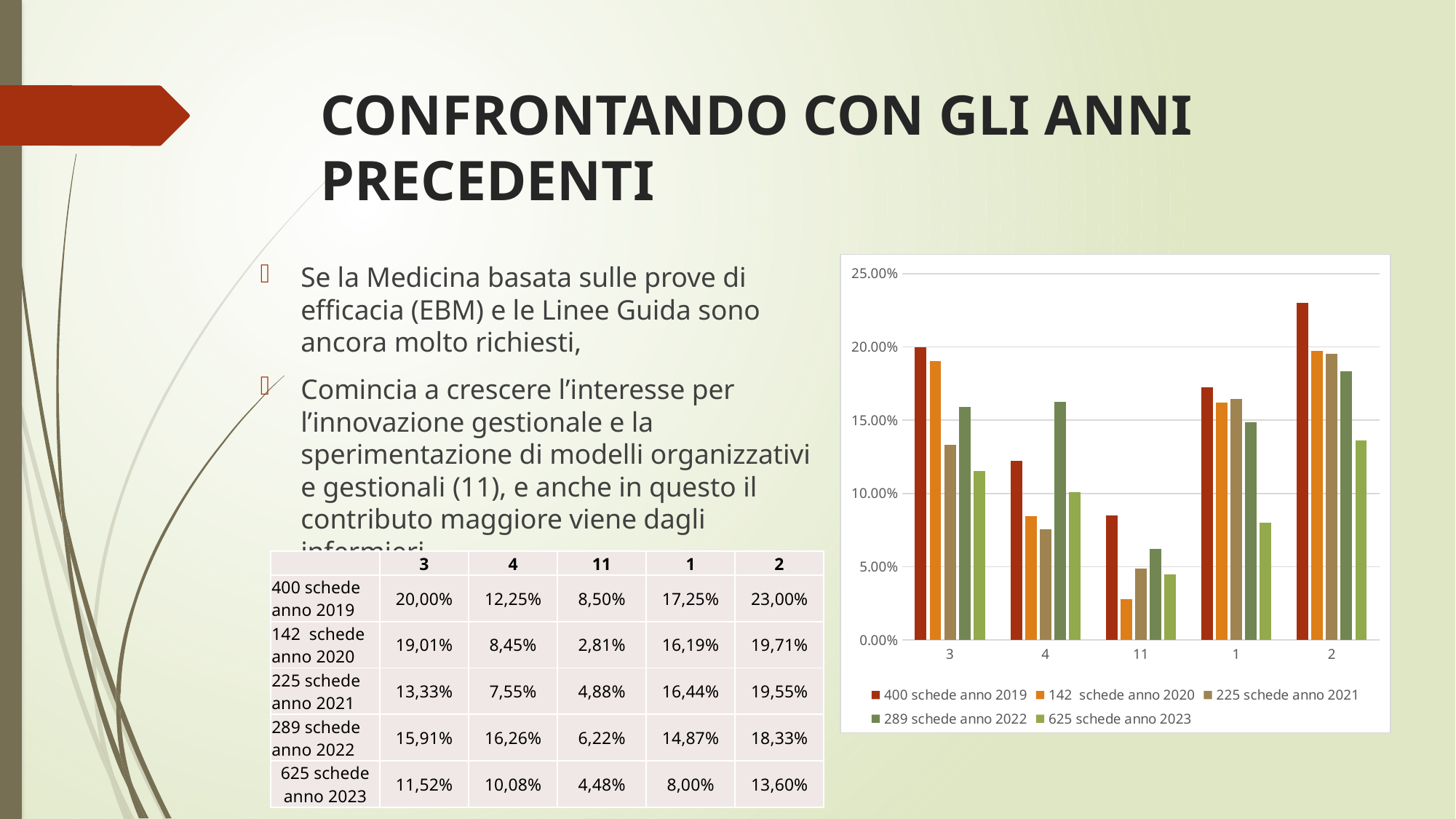
How many categories are shown on the x axis of the chart? 5 What is the value for category 4 in the series '289 schede anno 2022'? 16,26% Which series is shown in dark red in the chart? 400 schede anno 2019 How many series does the chart legend list? 5 Which category has the highest value in the series '625 schede anno 2023'? 2 What is the difference between the values for category 2 and category 1 in the series '400 schede anno 2019'? 5,75% For category 3, which series has the larger value: '400 schede anno 2019' or '625 schede anno 2023'? 400 schede anno 2019 Which category has the lowest value in the series '400 schede anno 2019'? 11 Is the value for category 2 in the series '400 schede anno 2019' greater or less than 20.00%? greater What kind of chart is shown on the slide? bar chart What is the value for category 11 in the series '142 schede anno 2020'? 2,81% What is the value for category 2 in the series '400 schede anno 2019'? 23,00%